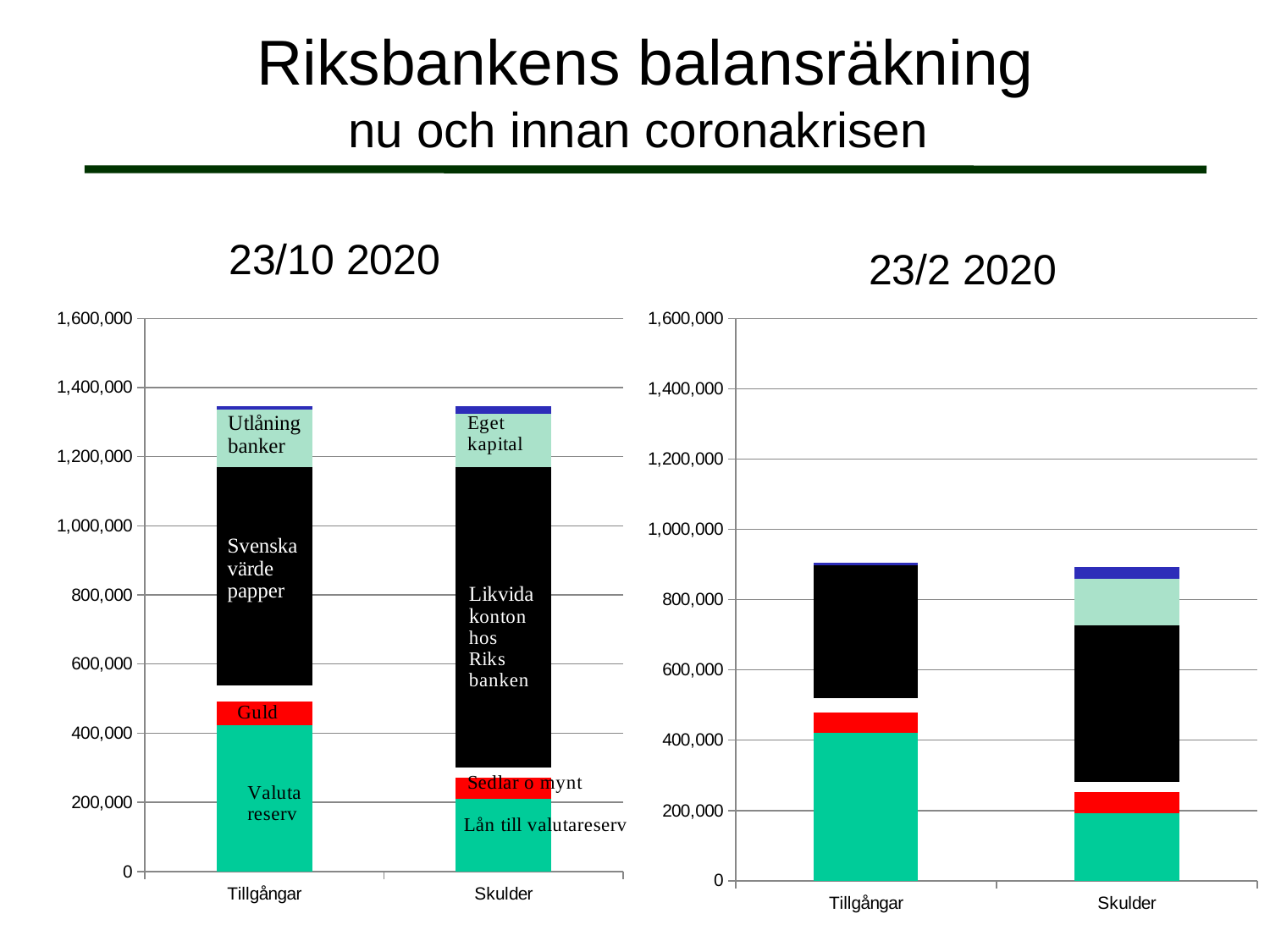
In the 23/2 2020 chart, is the total height of the Tillgångar bar greater or less than 1,000,000? less In the 23/10 2020 chart, is the Valutareserv segment of the Tillgångar bar greater or less than 600,000? less What is the highest value shown on the y axis of the 23/10 2020 chart? 1,600,000 Which chart has the taller Tillgångar bar, the 23/10 2020 chart or the 23/2 2020 chart? 23/10 2020 In the 23/2 2020 chart, is the total height of the Skulder bar greater or less than 800,000? greater In the 23/10 2020 chart, which segment of the Tillgångar bar is the largest? Svenska värdepapper In the 23/2 2020 chart on the right, how many categories are shown on the x axis? 2 What kind of chart is the 23/10 2020 chart on the left? stacked bar chart How many charts are shown on the slide? 2 In the 23/10 2020 chart, what colour is the segment labelled Guld? red